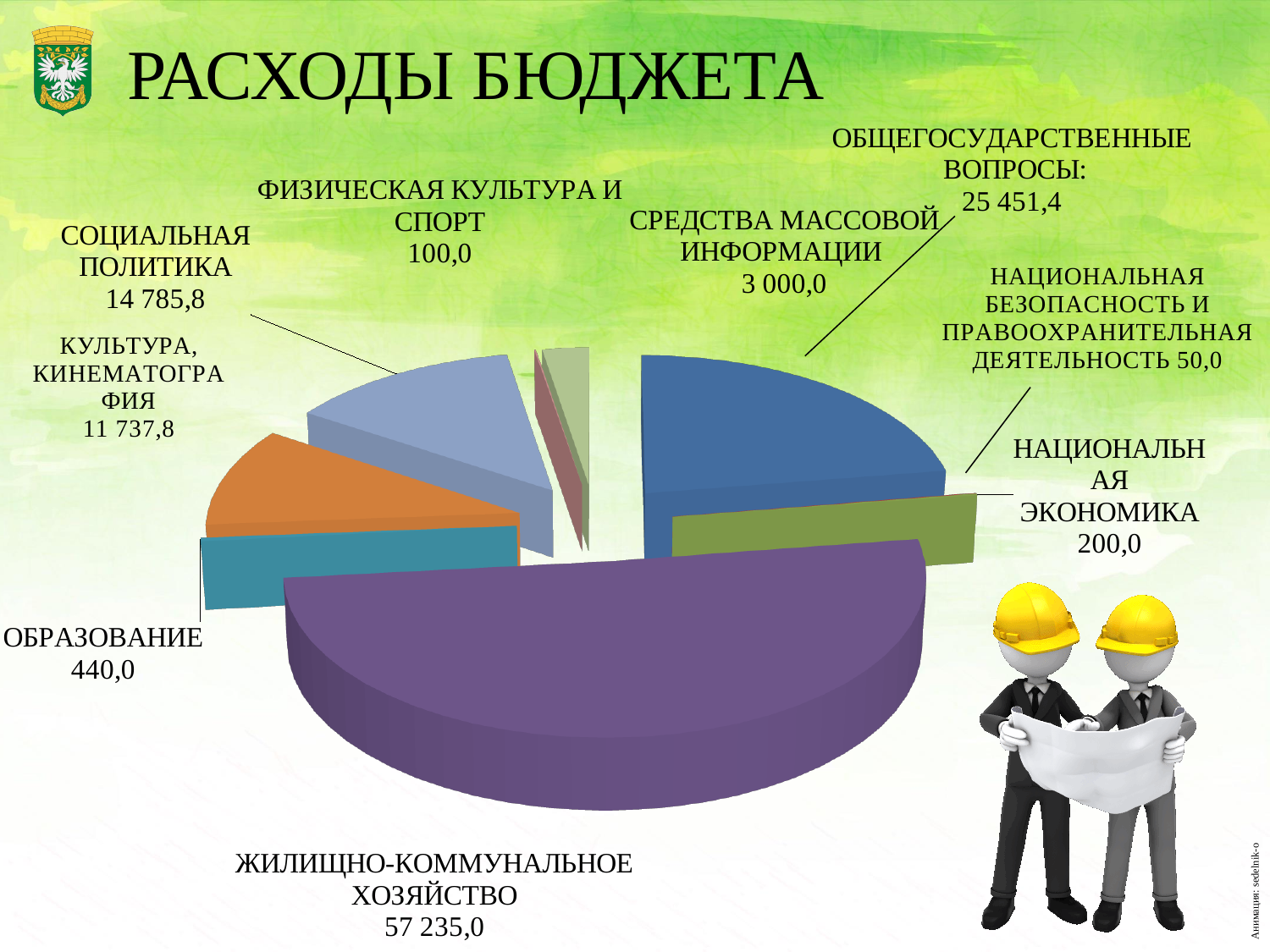
What is the difference between ОБРАЗОВАНИЕ and НАЦИОНАЛЬНАЯ ЭКОНОМИКА? 240,0 Which is larger, СОЦИАЛЬНАЯ ПОЛИТИКА or КУЛЬТУРА, КИНЕМАТОГРАФИЯ? СОЦИАЛЬНАЯ ПОЛИТИКА How many categories does the pie chart show? 9 What kind of chart is shown on the slide? Pie chart Which category has the smallest value? НАЦИОНАЛЬНАЯ БЕЗОПАСНОСТЬ И ПРАВООХРАНИТЕЛЬНАЯ ДЕЯТЕЛЬНОСТЬ What is the value for ОБЩЕГОСУДАРСТВЕННЫЕ ВОПРОСЫ? 25 451,4 What is the value for СОЦИАЛЬНАЯ ПОЛИТИКА? 14 785,8 What is the difference between ЖИЛИЩНО-КОММУНАЛЬНОЕ ХОЗЯЙСТВО and ОБЩЕГОСУДАРСТВЕННЫЕ ВОПРОСЫ? 31 783,6 What is the value for ЖИЛИЩНО-КОММУНАЛЬНОЕ ХОЗЯЙСТВО? 57 235,0 Which category has the largest value? ЖИЛИЩНО-КОММУНАЛЬНОЕ ХОЗЯЙСТВО What is the value for СРЕДСТВА МАССОВОЙ ИНФОРМАЦИИ? 3 000,0 What is the title of the chart on the slide? РАСХОДЫ БЮДЖЕТА